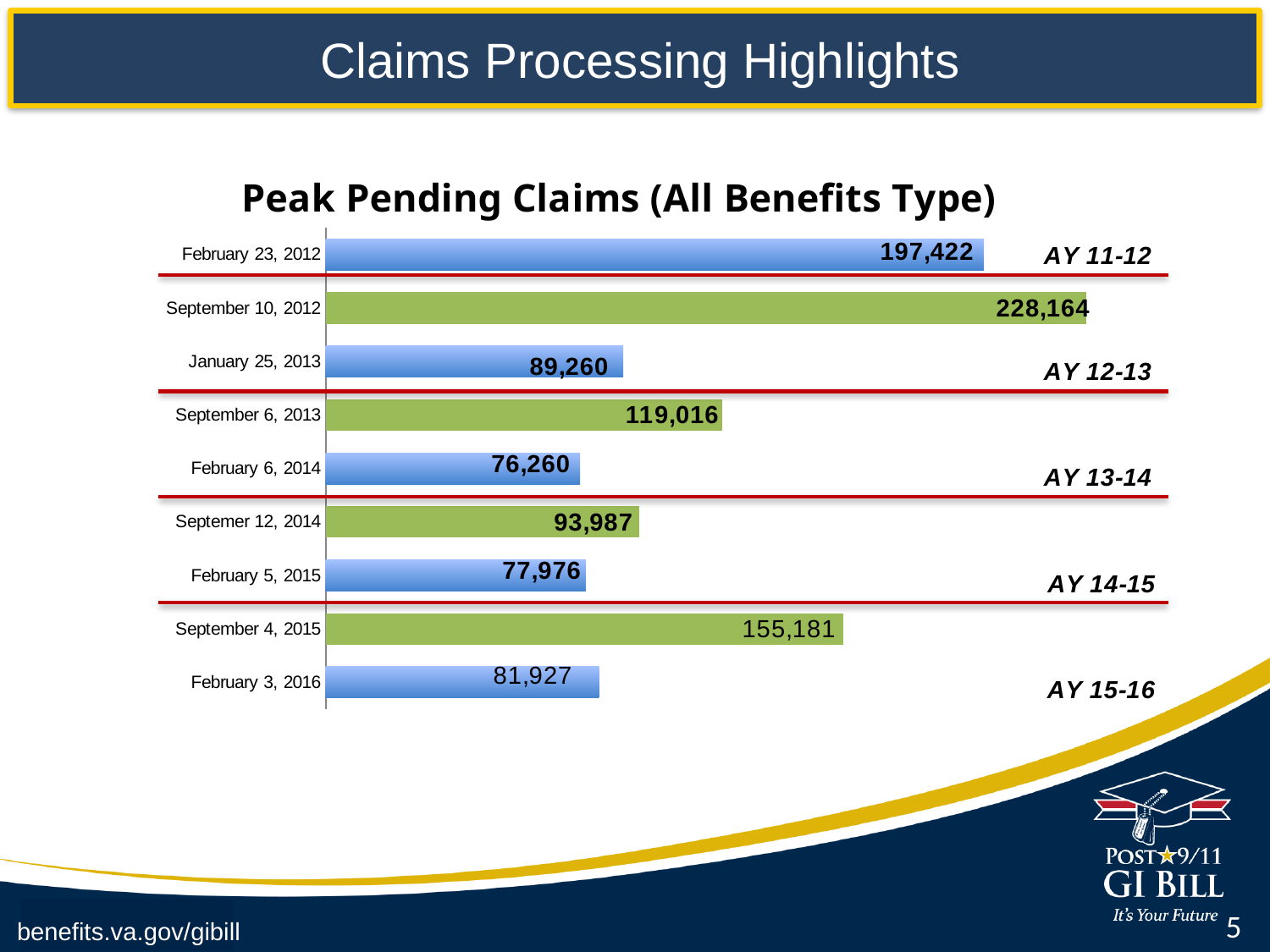
What colour is the bar for September 4, 2015? Green What is the difference between the values for September 10, 2012 and February 23, 2012? 30,742 What is the title of the chart? Peak Pending Claims (All Benefits Type) What is the value for September 6, 2013? 119,016 What is the value for September 10, 2012? 228,164 Which is larger, the value for January 25, 2013 or the value for September 12, 2014? September 12, 2014 What kind of chart is shown on the slide? Bar chart Which date has the lowest peak pending claims? February 6, 2014 Which date has the highest peak pending claims? September 10, 2012 What is the value for February 3, 2016? 81,927 What is the difference between the values for September 4, 2015 and February 3, 2016? 73,254 How many dates are shown in the chart? 9